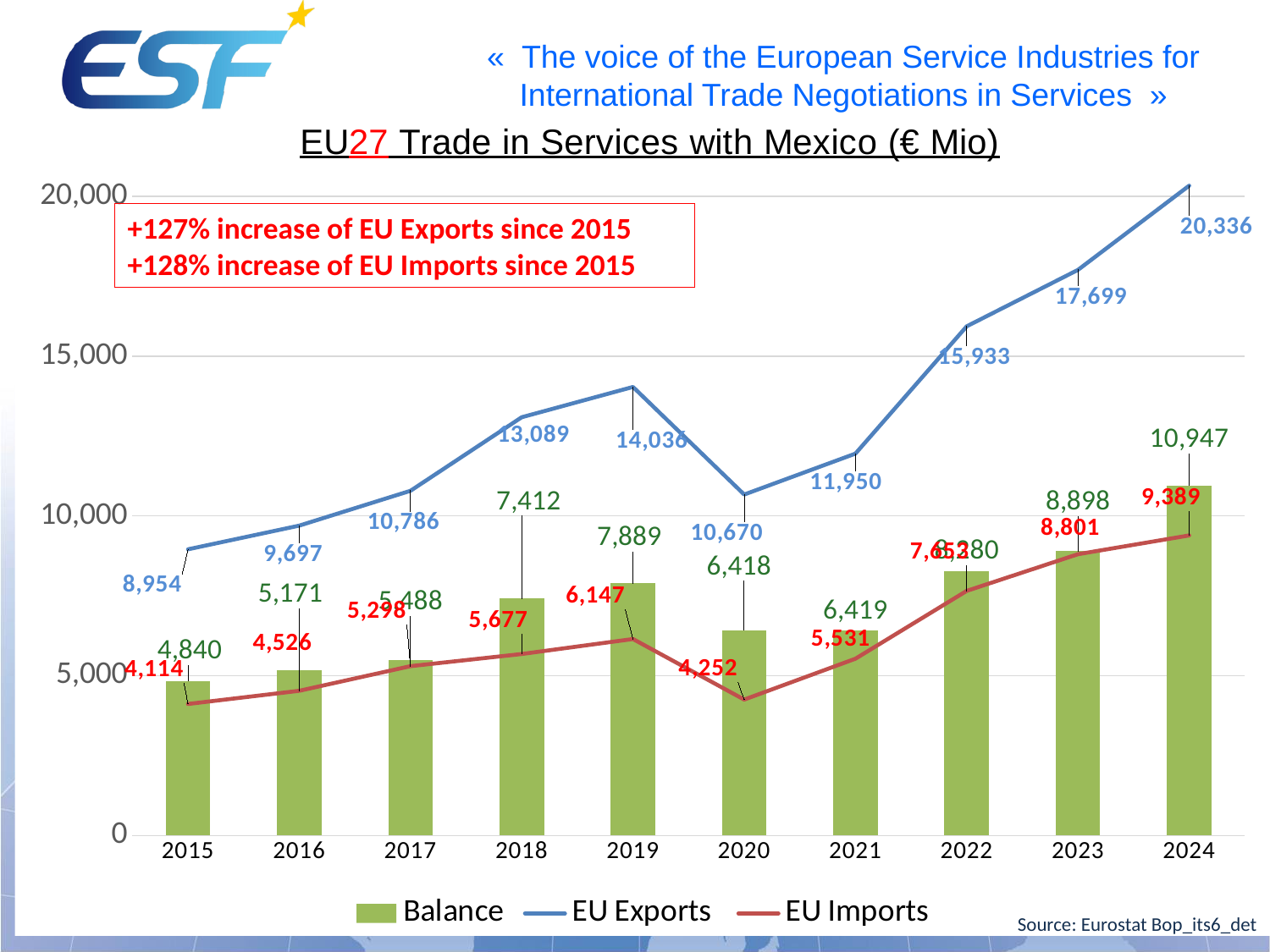
In which year is the Balance lowest? 2015 What is the value of EU Imports in 2015? 4,114 What is the Balance value for 2018? 7,412 How many series does the legend list? 3 Is the Balance value for 2024 greater or less than 10,000? greater By how much did EU Exports increase from 2023 to 2024? 2,637 What is the value of EU Exports in 2024? 20,336 In which year are EU Exports highest? 2024 How many years are shown on the x axis? 10 What is the value of EU Exports in 2020? 10,670 What kind of chart is this? Combined bar and line chart Which year has the larger EU Imports value, 2019 or 2020? 2019